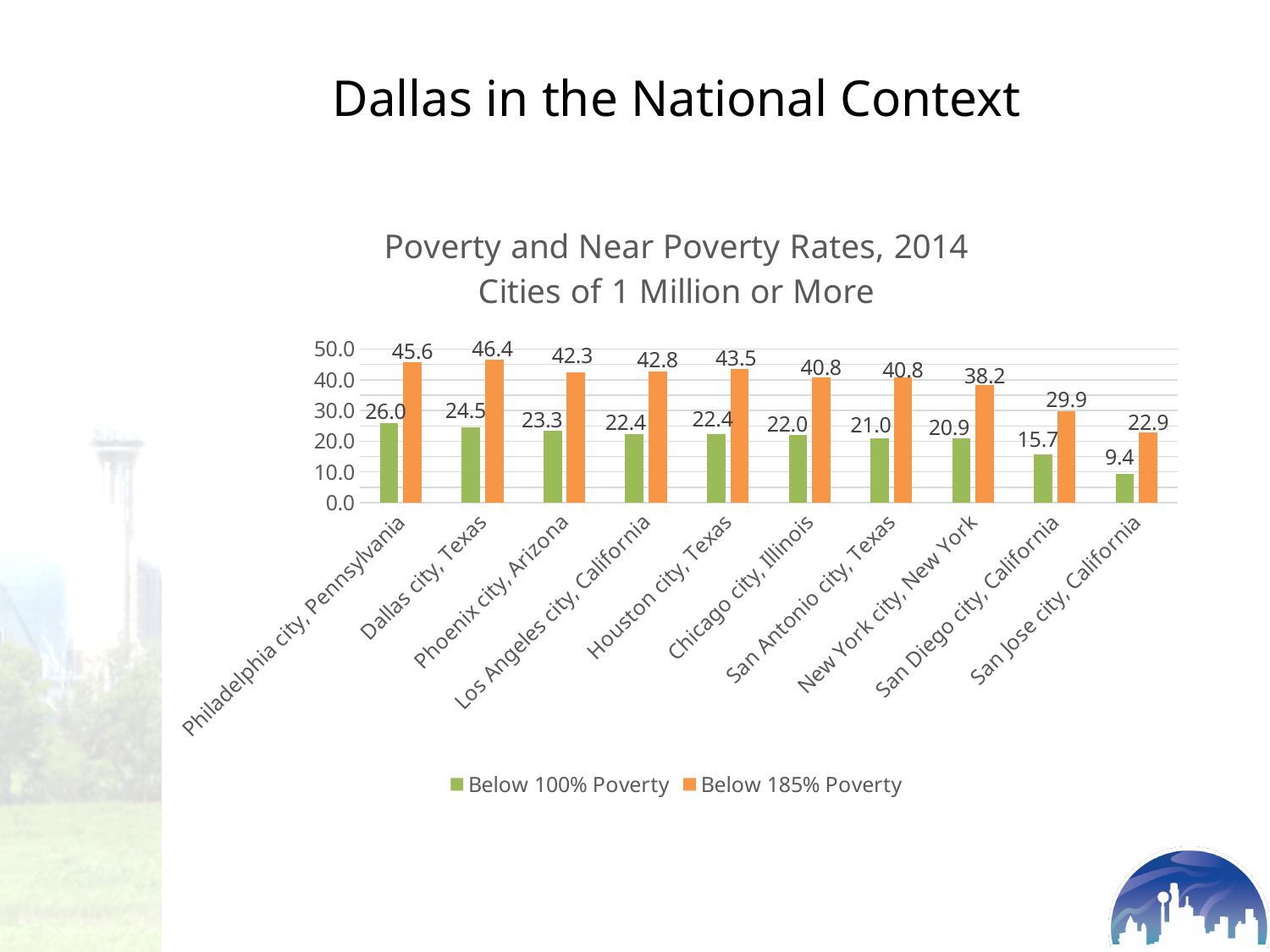
Which city has the highest Below 100% Poverty value? Philadelphia city, Pennsylvania What is the Below 100% Poverty value for Dallas city, Texas? 24.5 What is the title of the chart? Poverty and Near Poverty Rates, 2014 Cities of 1 Million or More How many cities are shown on the x axis? 10 What kind of chart is shown on the slide? Bar chart Which city has the highest Below 185% Poverty value? Dallas city, Texas What is the Below 185% Poverty value for Houston city, Texas? 43.5 How many series does the legend list? 2 Which is larger: the Below 100% Poverty value for Phoenix city, Arizona or for New York city, New York? Phoenix city, Arizona What is the Below 185% Poverty value for San Diego city, California? 29.9 Which city has the lowest Below 100% Poverty value? San Jose city, California What is the difference between the Below 185% Poverty and Below 100% Poverty values for Dallas city, Texas? 21.9